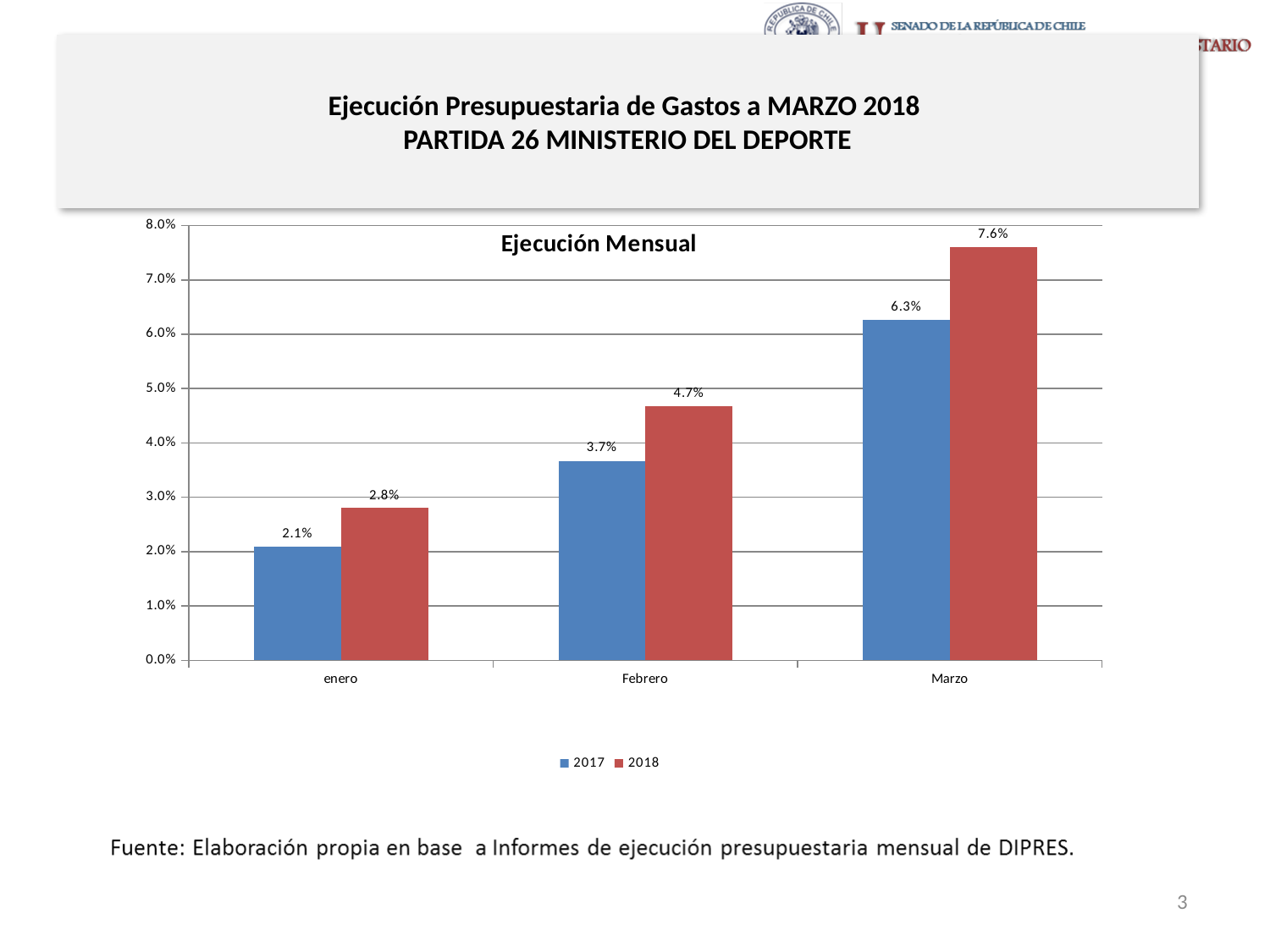
Is the value for 2017 in Febrero greater or less than 4.0%? less What is the value for 2017 in Marzo? 6.3% Which month has the lowest value for the 2017 series? enero Which is larger in Febrero, the 2017 value or the 2018 value? 2018 How many months are shown on the x axis? 3 What is the value for 2018 in Marzo? 7.6% What is the value for 2017 in enero? 2.1% What is the value for 2018 in Febrero? 4.7% How many series does the legend list? 2 What kind of chart is shown on the slide? bar chart Which month has the highest value for the 2018 series? Marzo What is the difference between the 2018 and 2017 values in Marzo? 1.3%